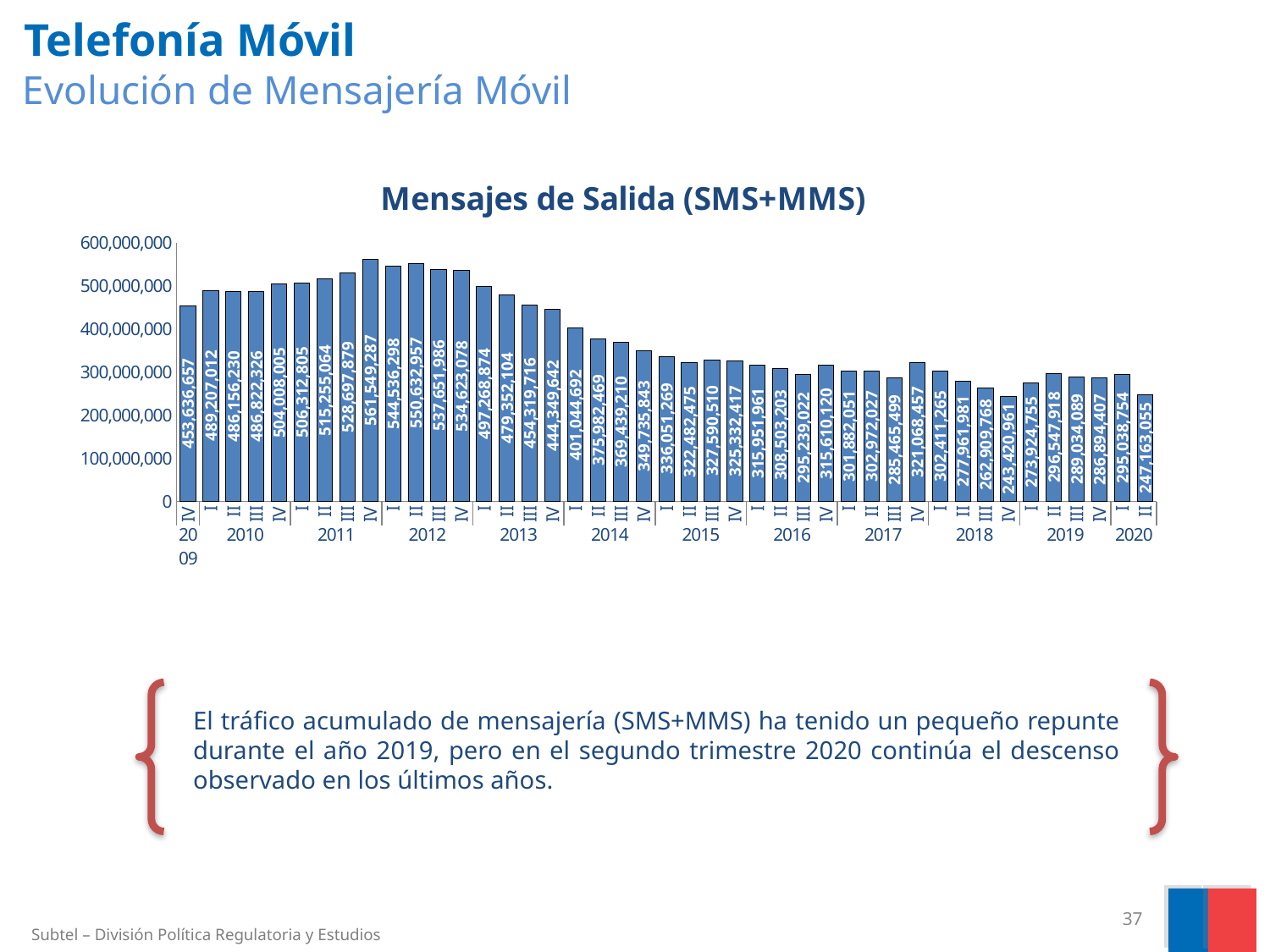
What is the value for quarter II of 2020? 247,163,055 Which quarter has the lowest value? IV 2018 Which quarter has the highest value? IV 2011 What type of chart is shown on the slide? Bar chart Do the values generally rise or fall from 2012 to 2018? fall How many bars are plotted in the chart? 43 What is the value for quarter IV of 2011? 561,549,287 Is the value for quarter IV of 2011 greater or less than 500,000,000? greater Which is larger, the value for quarter I of 2014 or the value for quarter I of 2015? I 2014 What is the title of the chart? Mensajes de Salida (SMS+MMS) What is the value for quarter I of 2014? 401,044,692 What is the difference between the values for quarter I of 2020 and quarter II of 2020? 47,875,699